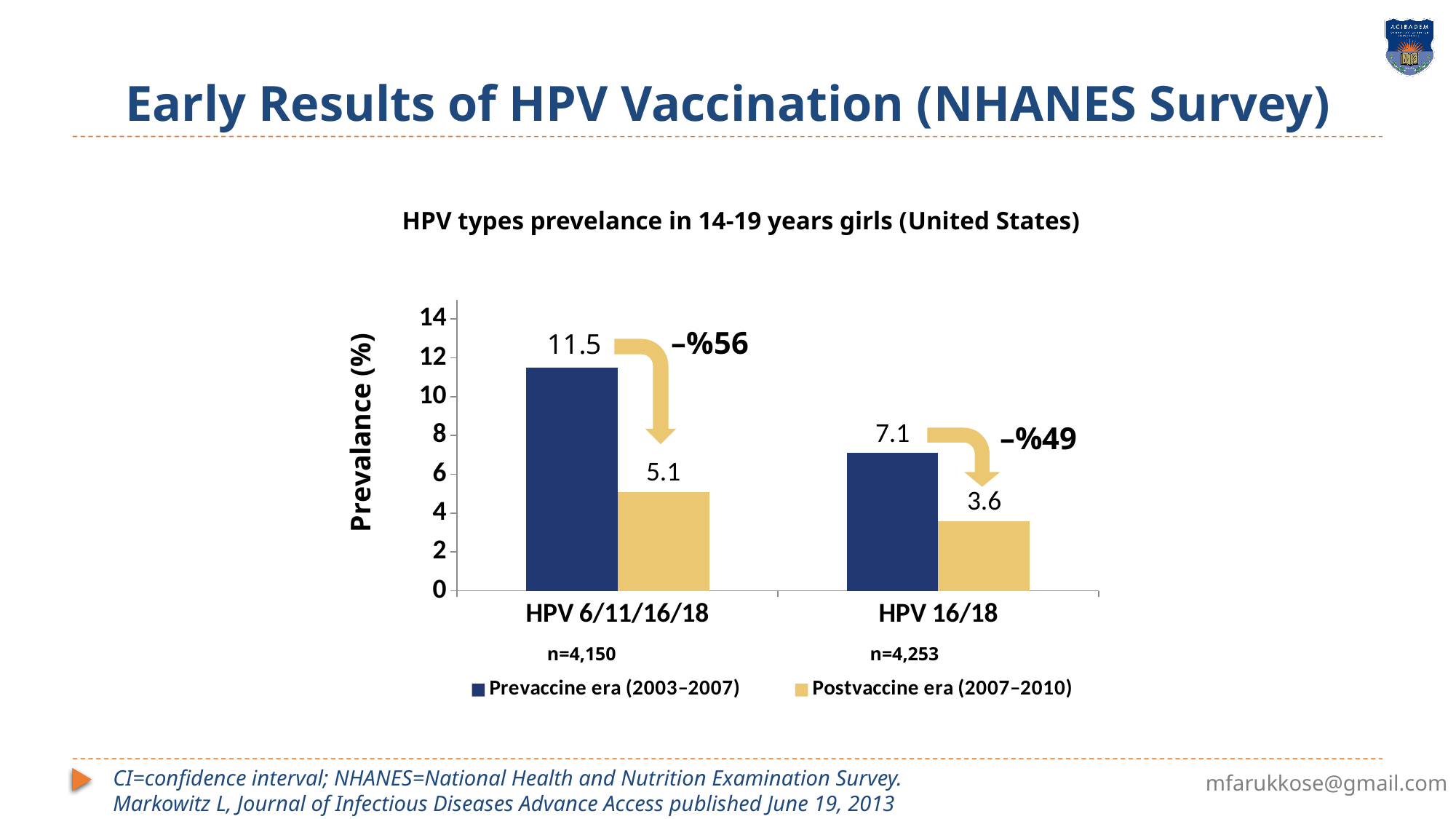
What percentage decrease is annotated for HPV 16/18? –%49 Which is larger: the postvaccine era prevalence for HPV 6/11/16/18 or the prevaccine era prevalence for HPV 16/18? Prevaccine era prevalence for HPV 16/18 Which bar shows the lowest prevalence on the chart? Postvaccine era (2007–2010) for HPV 16/18 What is the prevaccine era (2003–2007) prevalence for HPV 6/11/16/18? 11.5 What is the difference between the prevaccine and postvaccine prevalence for HPV 6/11/16/18? 6.4 What is the postvaccine era (2007–2010) prevalence for HPV 6/11/16/18? 5.1 How many categories are shown on the x axis? 2 What is the postvaccine era (2007–2010) prevalence for HPV 16/18? 3.6 How many series does the legend list? 2 Which category has the highest prevaccine era (2003–2007) prevalence? HPV 6/11/16/18 What kind of chart is shown on the slide? Bar chart What is the difference between the prevaccine and postvaccine prevalence for HPV 16/18? 3.5